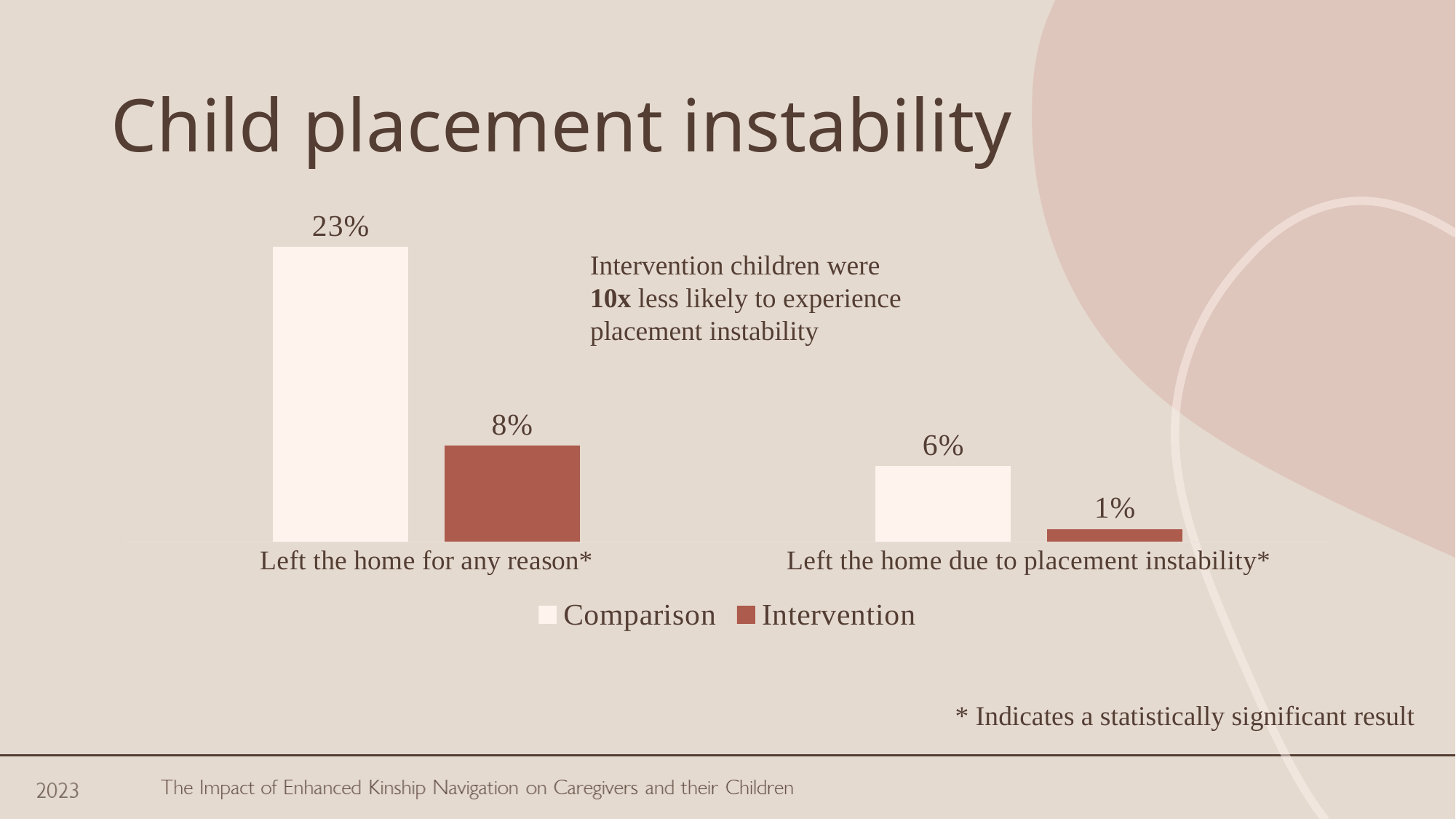
What is the Comparison value for "Left the home for any reason*"? 23% What is the Intervention value for "Left the home due to placement instability*"? 1% What is the difference between the Comparison and Intervention values for "Left the home for any reason*"? 15% What is the Intervention value for "Left the home for any reason*"? 8% What is the Comparison value for "Left the home due to placement instability*"? 6% What is the difference between the Comparison and Intervention values for "Left the home due to placement instability*"? 5% What type of chart is shown on the slide? Bar chart How many categories are shown on the x axis of the chart? 2 Which bar in the chart has the lowest value? Intervention, Left the home due to placement instability* For "Left the home due to placement instability*", which group has the larger value, Comparison or Intervention? Comparison How many series does the chart's legend list? 2 Which bar in the chart has the highest value? Comparison, Left the home for any reason*